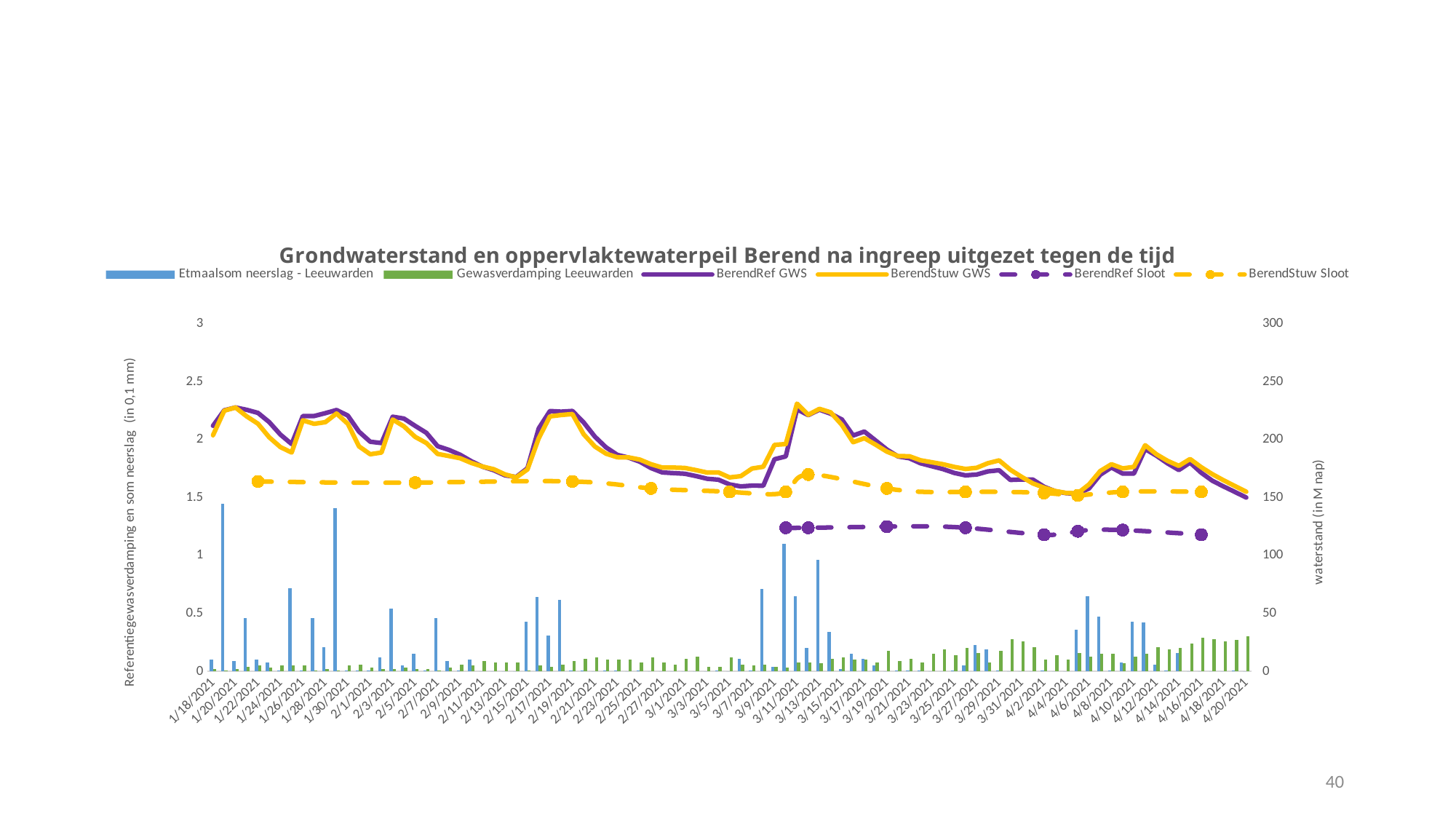
Is the value of BerendRef Sloot on 3/11/2021 greater or less than 150 on the right axis? less Is the Etmaalsom neerslag - Leeuwarden bar on 1/19/2021 greater or less than 1 on the left axis? greater Is the value of BerendRef GWS on 1/20/2021 greater or less than 200 on the right axis? greater Does BerendStuw GWS rise or fall between 4/12/2021 and 4/20/2021? fall Overall, do the BerendRef GWS values rise or fall from 1/18/2021 to 4/20/2021? fall On 3/11/2021, which is higher: BerendRef Sloot or BerendStuw Sloot? BerendStuw Sloot What is the title of the chart? Grondwaterstand en oppervlaktewaterpeil Berend na ingreep uitgezet tegen de tijd What kind of chart is shown on the slide? A combination bar and line chart What is the label of the right-hand vertical axis? waterstand (in M nap) How many series does the legend list? 6 Which is higher for BerendRef GWS: the value on 1/20/2021 or the value on 4/20/2021? 1/20/2021